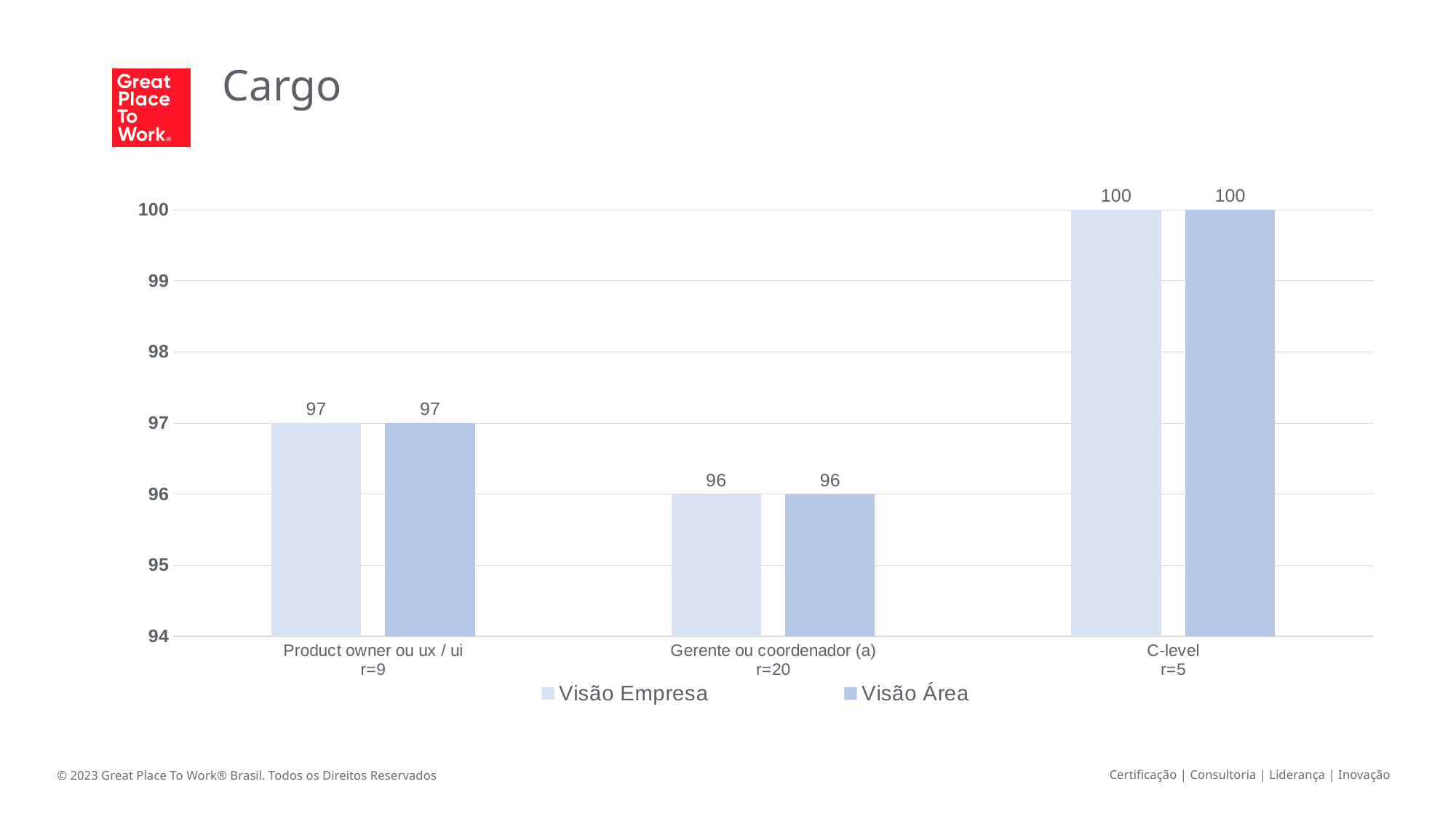
Which is larger: the Visão Empresa value for Product owner ou ux / ui or the Visão Empresa value for Gerente ou coordenador (a)? Product owner ou ux / ui What kind of chart is shown on the slide? Bar chart What is the title of the slide? Cargo What is the difference between the Visão Área value for C-level and the Visão Área value for Product owner ou ux / ui? 3 What is the Visão Empresa value for Product owner ou ux / ui? 97 What is the Visão Empresa value for C-level? 100 What is the r value shown under the Gerente ou coordenador (a) category? r=20 Which category has the lowest Visão Empresa value? Gerente ou coordenador (a) What is the Visão Área value for Gerente ou coordenador (a)? 96 How many categories are shown on the x axis? 3 How many series does the legend list? 2 Which category has the highest Visão Área value? C-level